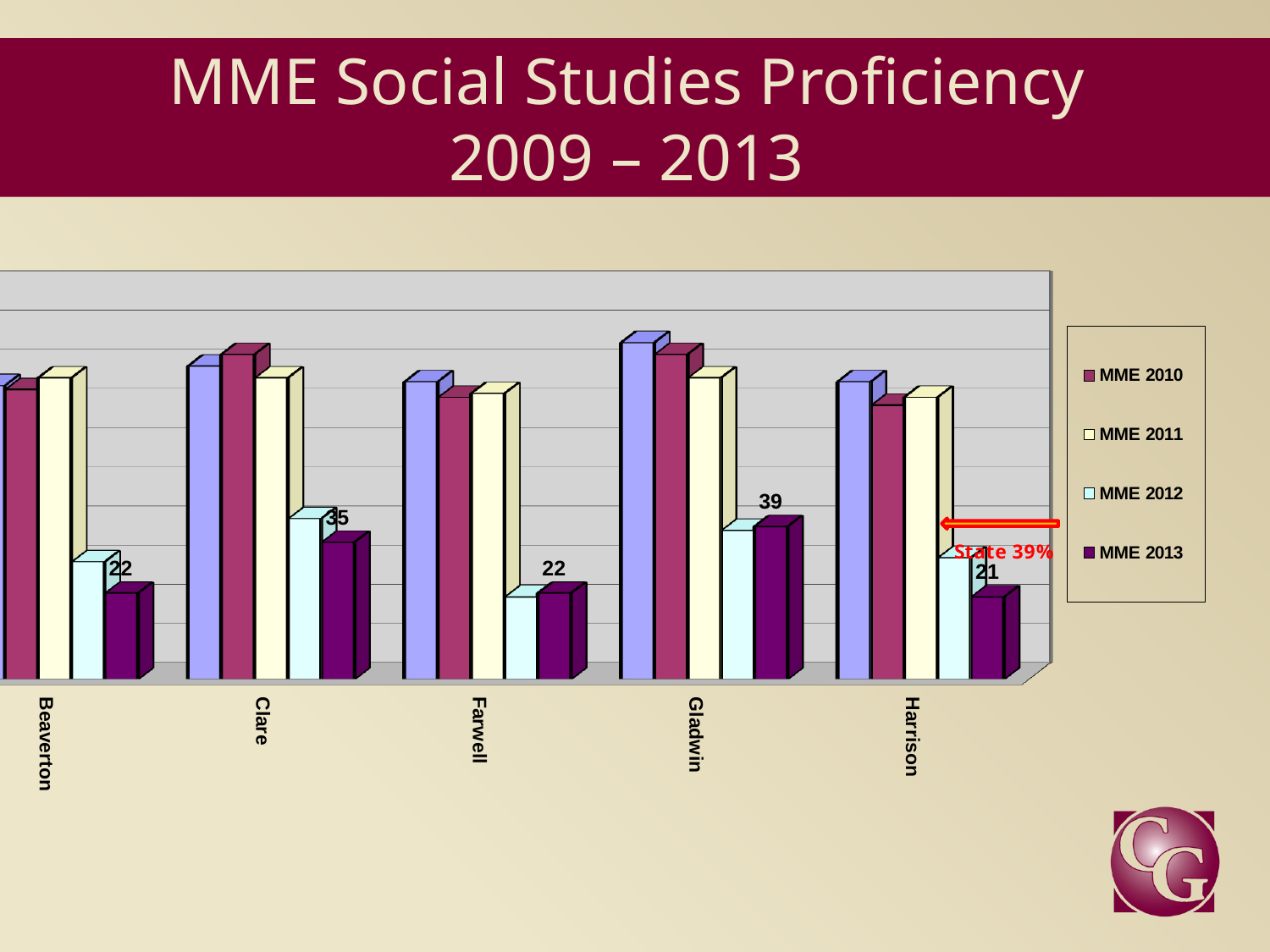
What is the MME 2013 value for Clare? 35 Which has the larger MME 2013 value, Clare or Farwell? Clare What is the MME 2013 value for Gladwin? 39 What state proficiency percentage is annotated on the chart? State 39% What is the MME 2013 value for Farwell? 22 How many districts are shown on the x axis of the chart? 5 What kind of chart is shown on the slide? Bar chart How many series does the chart's legend list? 4 What is the MME 2013 value for Harrison? 21 Which district has the highest MME 2013 value? Gladwin Which district has the lowest MME 2013 value? Harrison What is the difference between the MME 2013 values for Gladwin and Harrison? 18